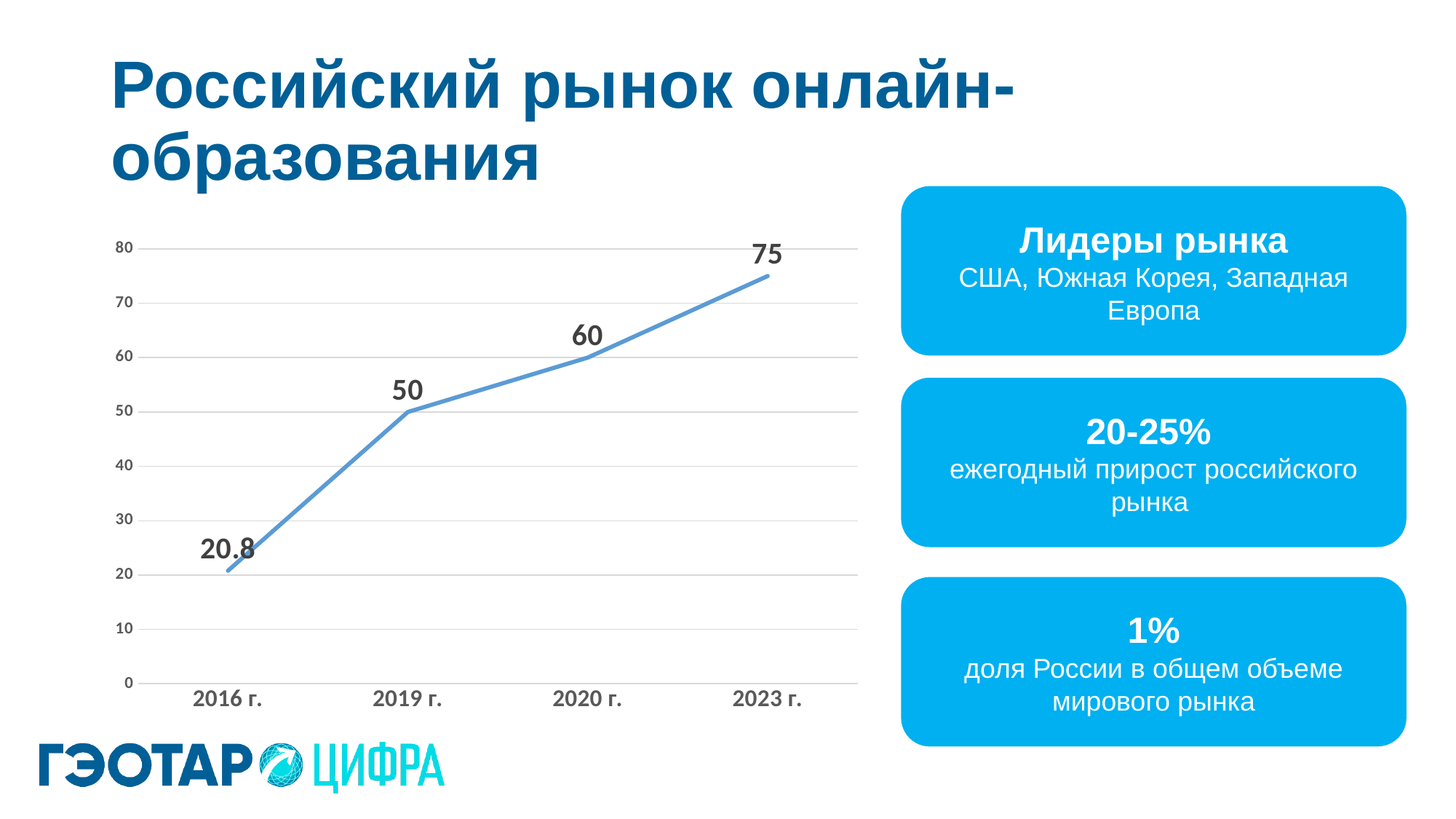
What is the value for 2019 г.? 50 Which is larger, the value for 2019 г. or the value for 2020 г.? 2020 г. What is the difference between the values for 2023 г. and 2020 г.? 15 Which year has the highest value? 2023 г. Which year has the lowest value? 2016 г. What is the value for 2016 г.? 20.8 What is the value for 2023 г.? 75 How many data points are plotted on the chart? 4 What is the value for 2020 г.? 60 Do the values rise or fall from 2016 г. to 2023 г.? rise What is the difference between the values for 2019 г. and 2016 г.? 29.2 What kind of chart is shown on the slide? line chart